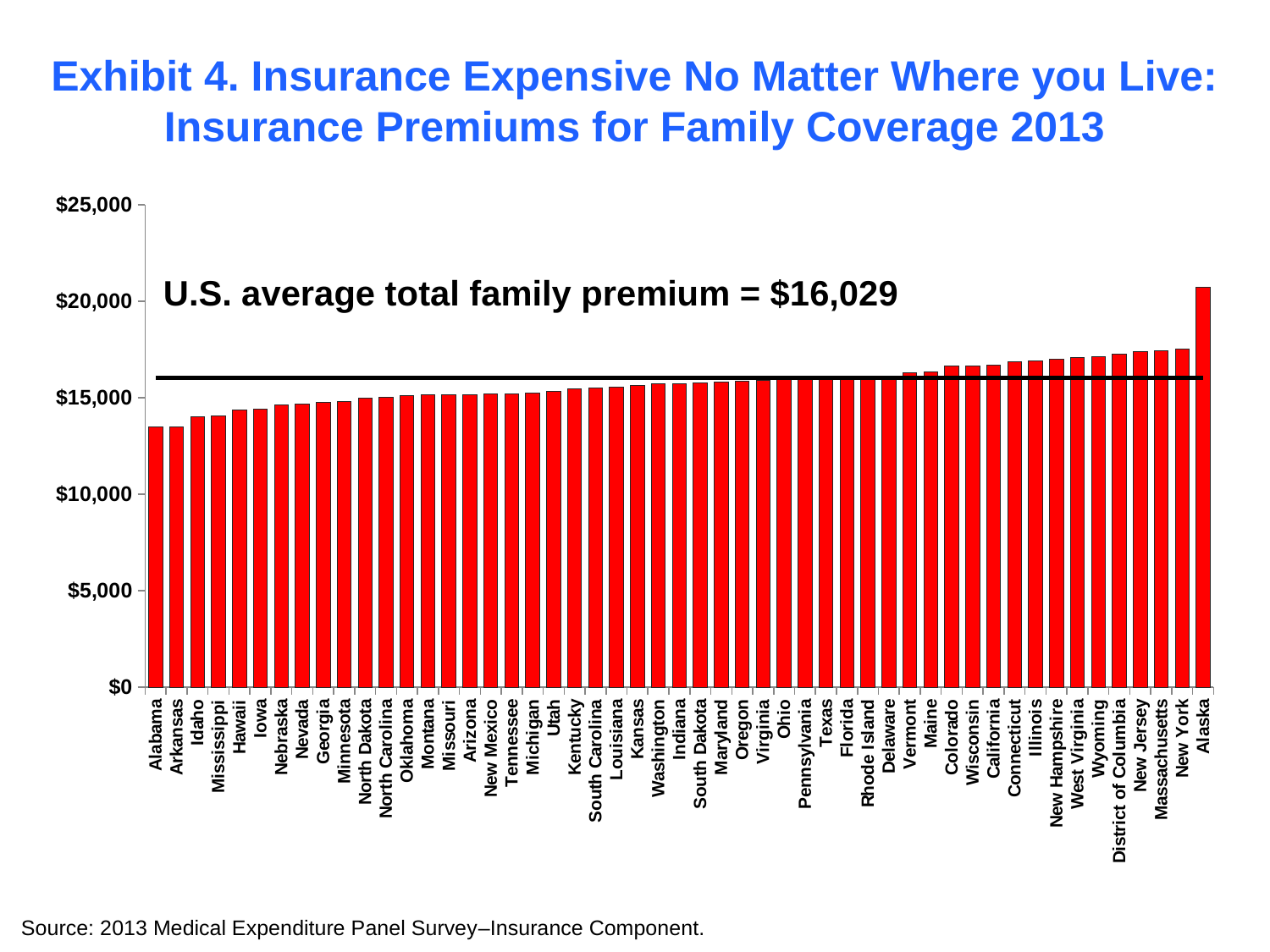
What U.S. average total family premium is stated on the chart? $16,029 Which has a higher family premium, Alaska or Alabama? Alaska Is the value for Alabama greater or less than $15,000? less Is the value for New York greater or less than $15,000? greater Is the value for Idaho greater or less than $15,000? less Which state has the highest family insurance premium in the chart? Alaska Which has a higher family premium, New York or Idaho? New York How many states or jurisdictions are plotted in the chart? 51 What is the source cited for the chart data? 2013 Medical Expenditure Panel Survey–Insurance Component Do the bar values rise or fall moving from left to right along the x axis? Rise What kind of chart is shown on the slide? Bar chart